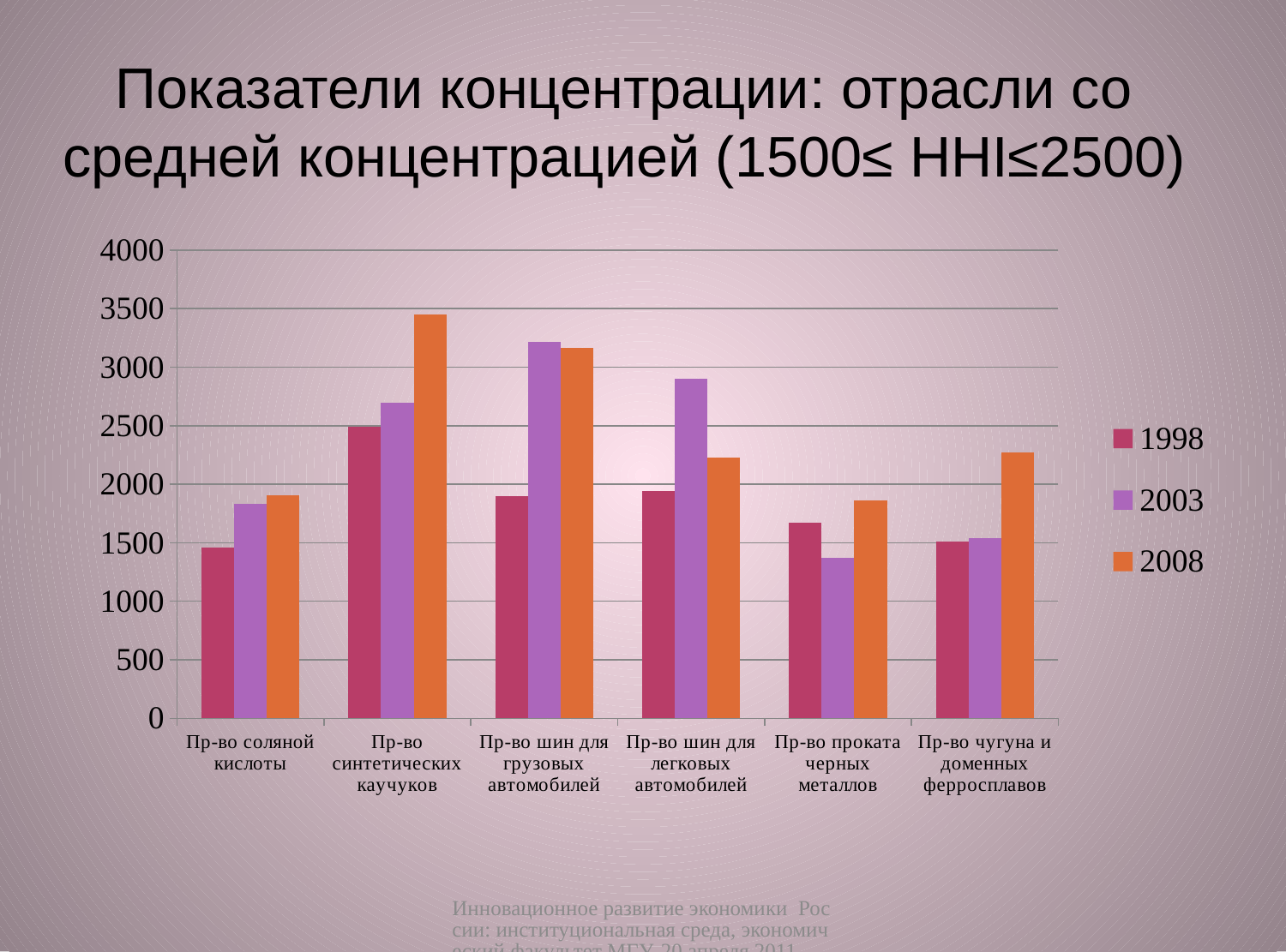
Which category has the highest value for 2008? Пр-во синтетических каучуков For Пр-во шин для легковых автомобилей, which is larger: the 2003 value or the 2008 value? 2003 Is the 2008 value for Пр-во синтетических каучуков greater or less than 3000? greater For Пр-во соляной кислоты, do the values rise or fall from 1998 to 2008? rise How many series does the legend list? 3 What kind of chart is shown on the slide? bar chart Which category has the highest value for 1998? Пр-во синтетических каучуков Which category has the lowest value for 2003? Пр-во проката черных металлов For Пр-во чугуна и доменных ферросплавов, which is larger: the 1998 value or the 2008 value? 2008 Which years are listed in the legend? 1998, 2003, 2008 Is the 2003 value for Пр-во проката черных металлов greater or less than 1500? less How many industry categories are shown on the x axis? 6